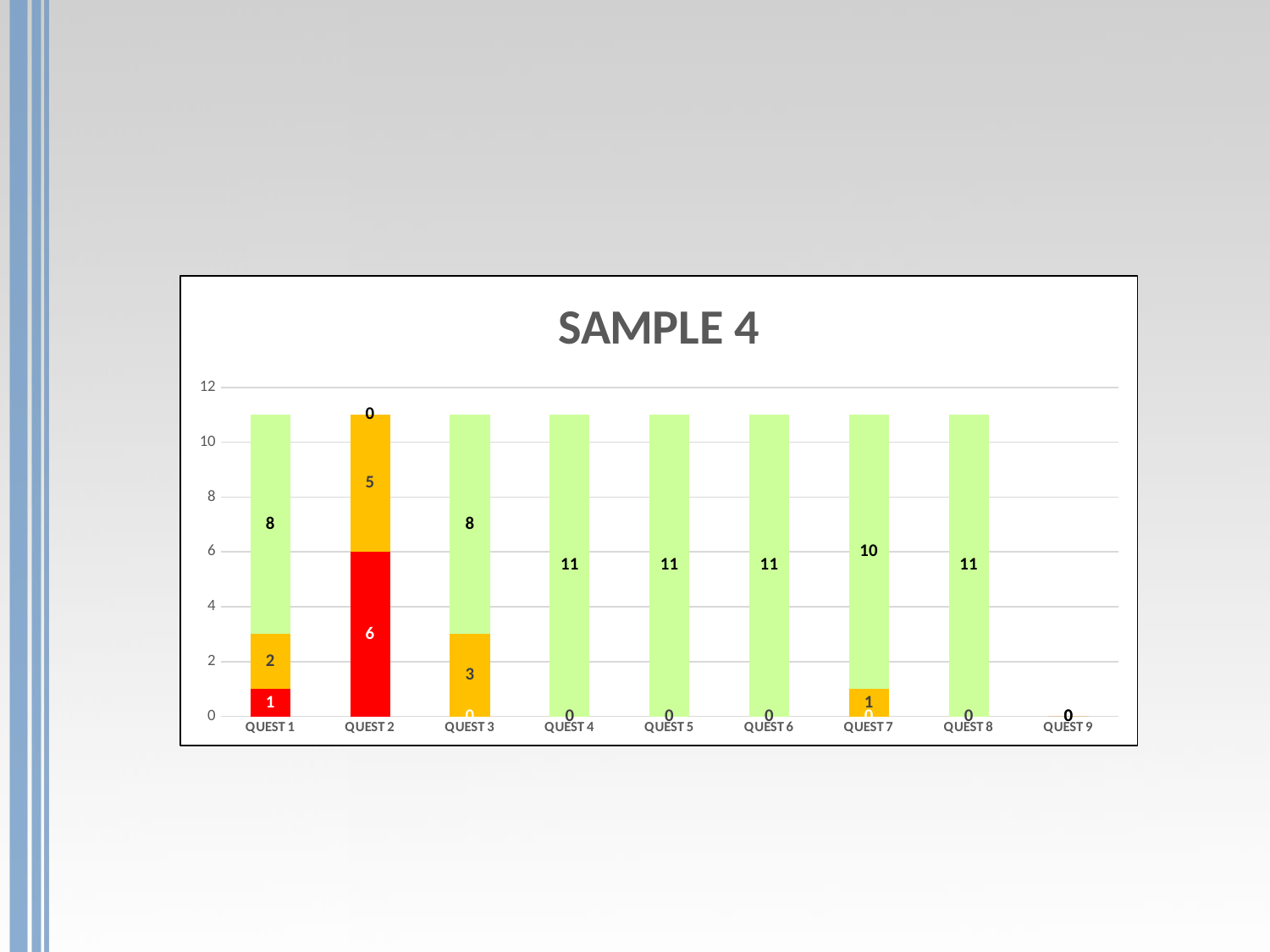
What is the difference between the orange segment of QUEST 2 and the orange segment of QUEST 1? 3 What is the total of the stacked bar for QUEST 1? 11 What is the value of the red segment for QUEST 2? 6 What is the total of the stacked bar for QUEST 2? 11 What kind of chart is shown on the slide? Stacked bar chart Which category has the largest red segment? QUEST 2 What is the value of the orange segment for QUEST 3? 3 How many categories are shown on the x axis of the chart? 9 What is the value of the green segment for QUEST 7? 10 What is the value of the green segment for QUEST 1? 8 What is the title of the chart? SAMPLE 4 Is the green segment for QUEST 2 larger or smaller than the green segment for QUEST 3? Smaller